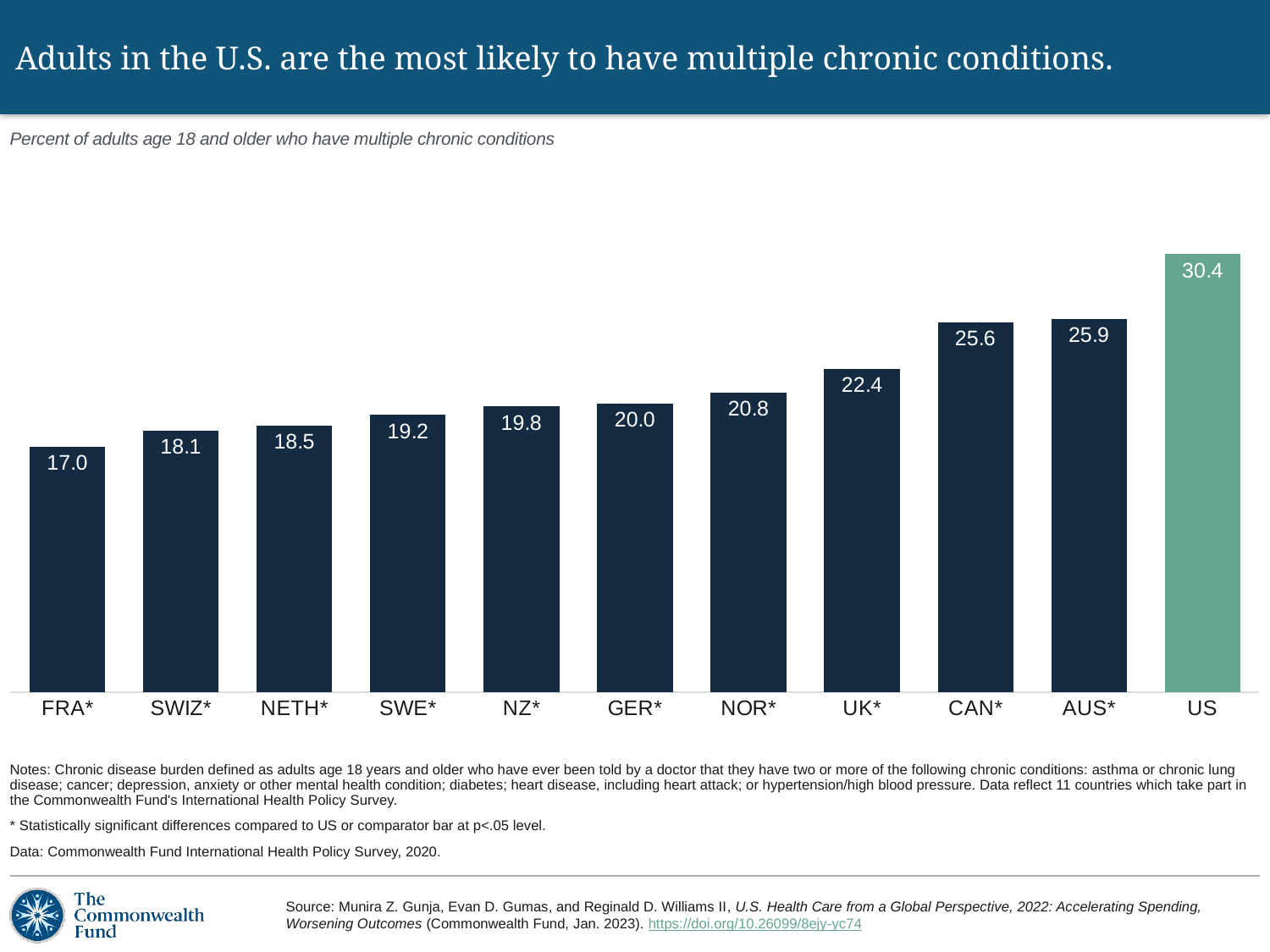
Do the values rise or fall from left to right along the x axis? Rise What is the difference between the values for US and AUS*? 4.5 What is the value for GER*? 20.0 What is the value for CAN*? 25.6 Which country has the lowest value? FRA* Which is larger, the value for NOR* or the value for SWE*? NOR* What is the value for the US? 30.4 Which bar is shown in a different colour from the others? US How many countries are shown in the chart? 11 Which country has the highest value? US What kind of chart is shown on the slide? Bar chart What is the difference between the values for UK* and FRA*? 5.4